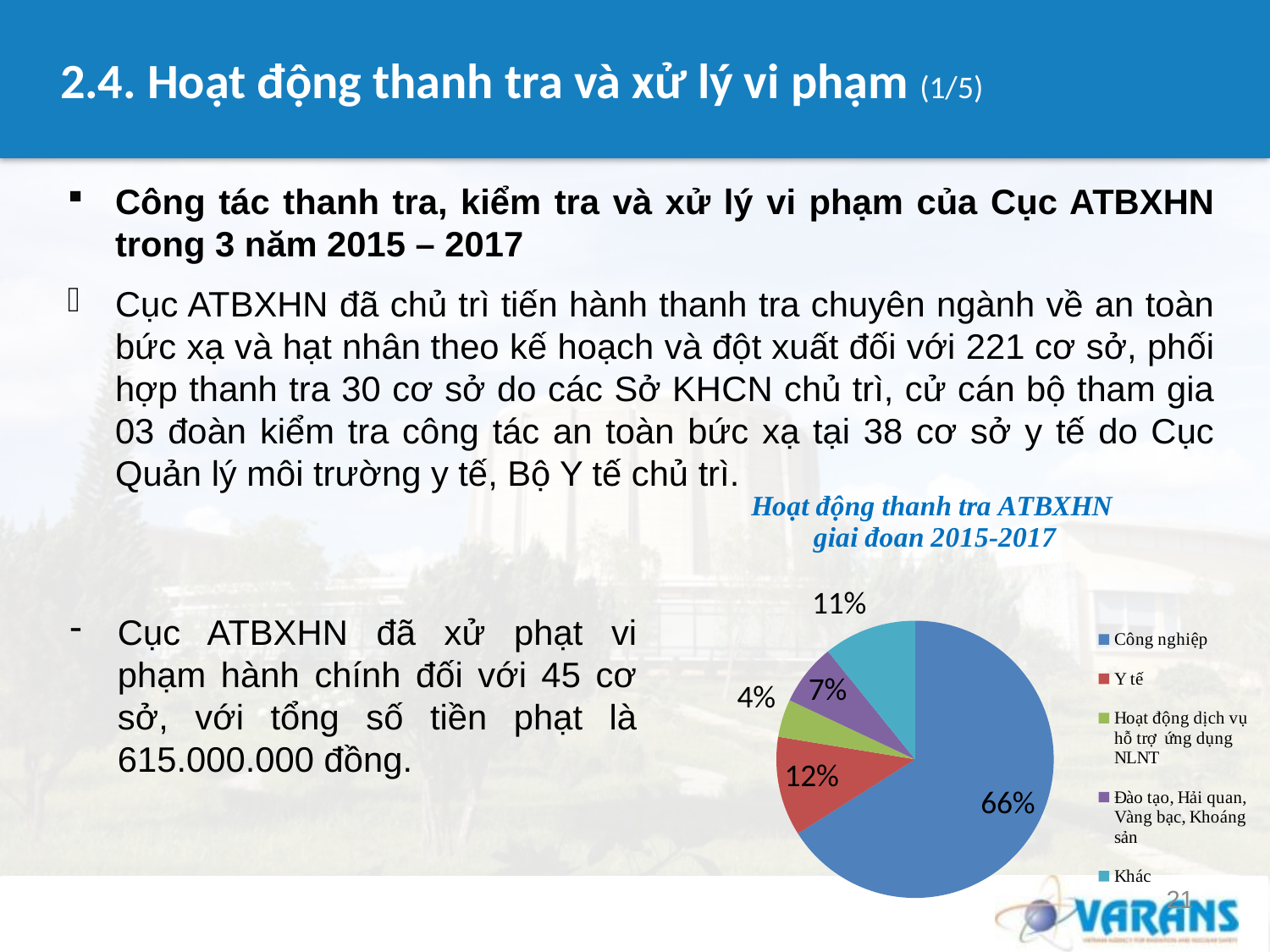
What share of the pie does Khác have? 11% What share of the pie does Hoạt động dịch vụ hỗ trợ ứng dụng NLNT have? 4% What kind of chart is shown on the slide? pie chart What share of the pie does Đào tạo, Hải quan, Vàng bạc, Khoáng sản have? 7% Which category has the smallest share of the pie? Hoạt động dịch vụ hỗ trợ ứng dụng NLNT How many categories does the pie chart show? 5 Which category has the largest share of the pie? Công nghiệp Which is larger, the share for Y tế or the share for Khác? Y tế What is the title of the chart on the slide? Hoạt động thanh tra ATBXHN giai đoan 2015-2017 What is the difference in percentage points between the share for Công nghiệp and the share for Y tế? 54